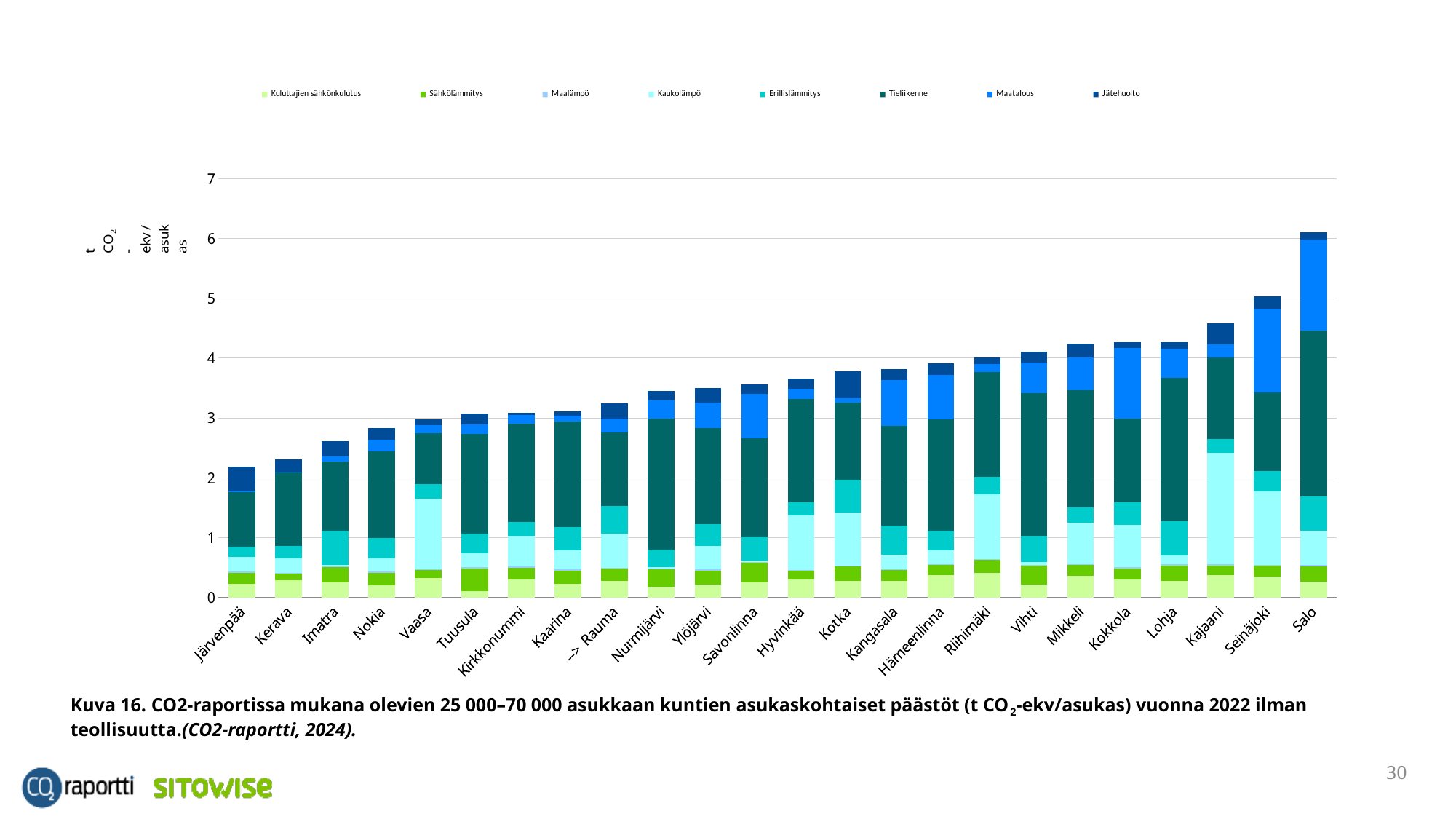
What kind of chart is shown on the slide? stacked bar chart How many series does the legend list? 8 Which municipality has the lowest total emissions per inhabitant? Järvenpää Is the total value for Kerava greater or less than 2? greater Is the total value for Järvenpää greater or less than 3? less How many municipalities are shown on the x axis? 24 Which has a larger total, Kajaani or Nokia? Kajaani Which series is listed first in the legend? Kuluttajien sähkönkulutus Which municipality has the highest total emissions per inhabitant? Salo Is the total value for Salo greater or less than 6? greater Do the total bar heights rise or fall from left to right along the x axis? rise